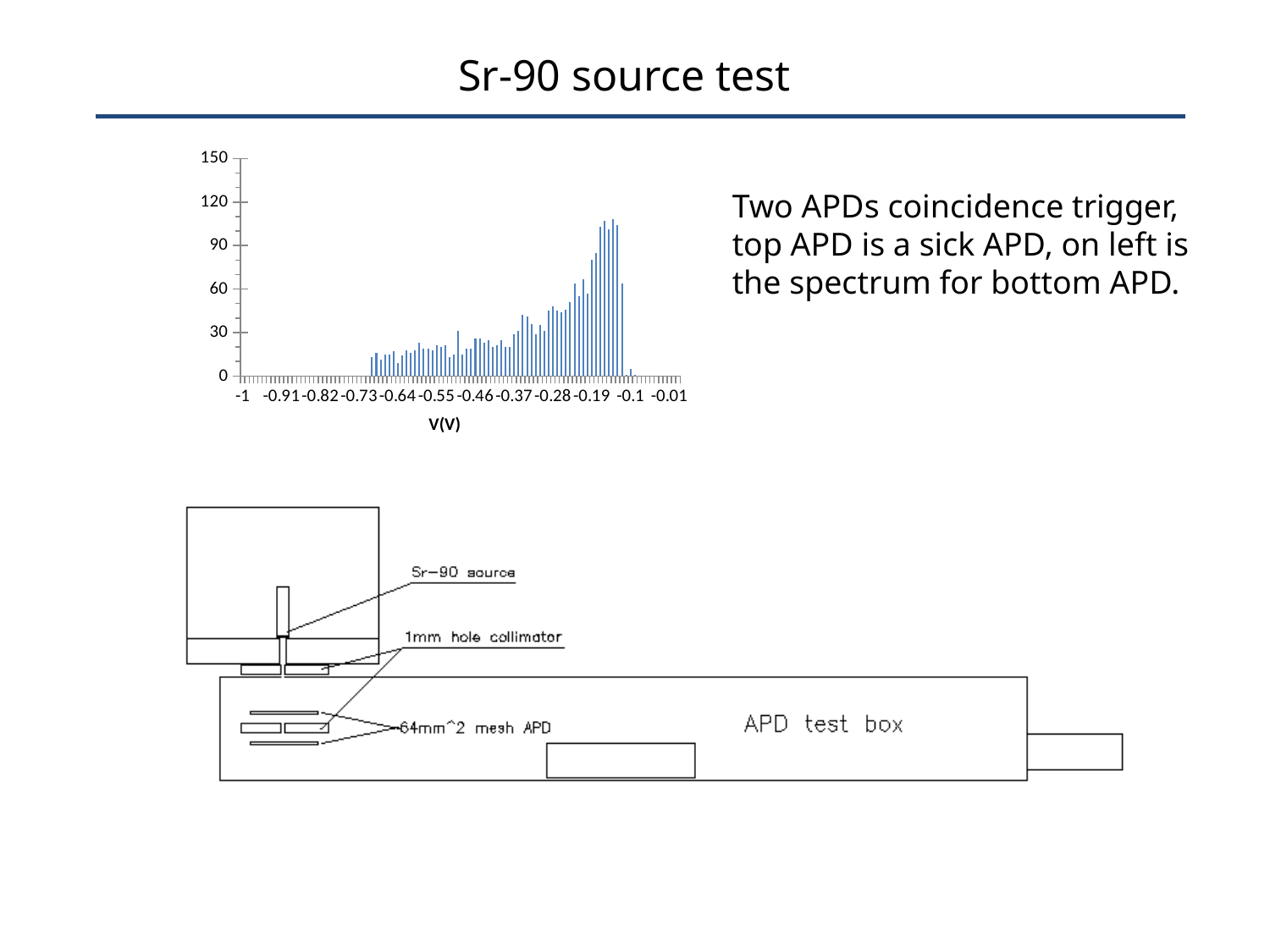
Are the bars near -0.19 on the x axis taller or shorter than the bars near -0.64? taller In which region of the x axis is the tallest bar located: near -0.15 or near -0.55? near -0.15 Are the bars near -0.37 on the x axis greater or less than 60? less Is the tallest bar in the chart greater or less than 120? less Are the bars near -0.64 on the x axis greater or less than 30? less Are there any bars plotted between -1 and -0.82 on the x axis? no Do the bar heights generally rise or fall as V goes from -0.7 toward -0.15? rise What is the label on the x axis of the chart? V(V) What is the highest value shown on the y axis of the chart? 150 What kind of chart is shown on the slide? bar chart